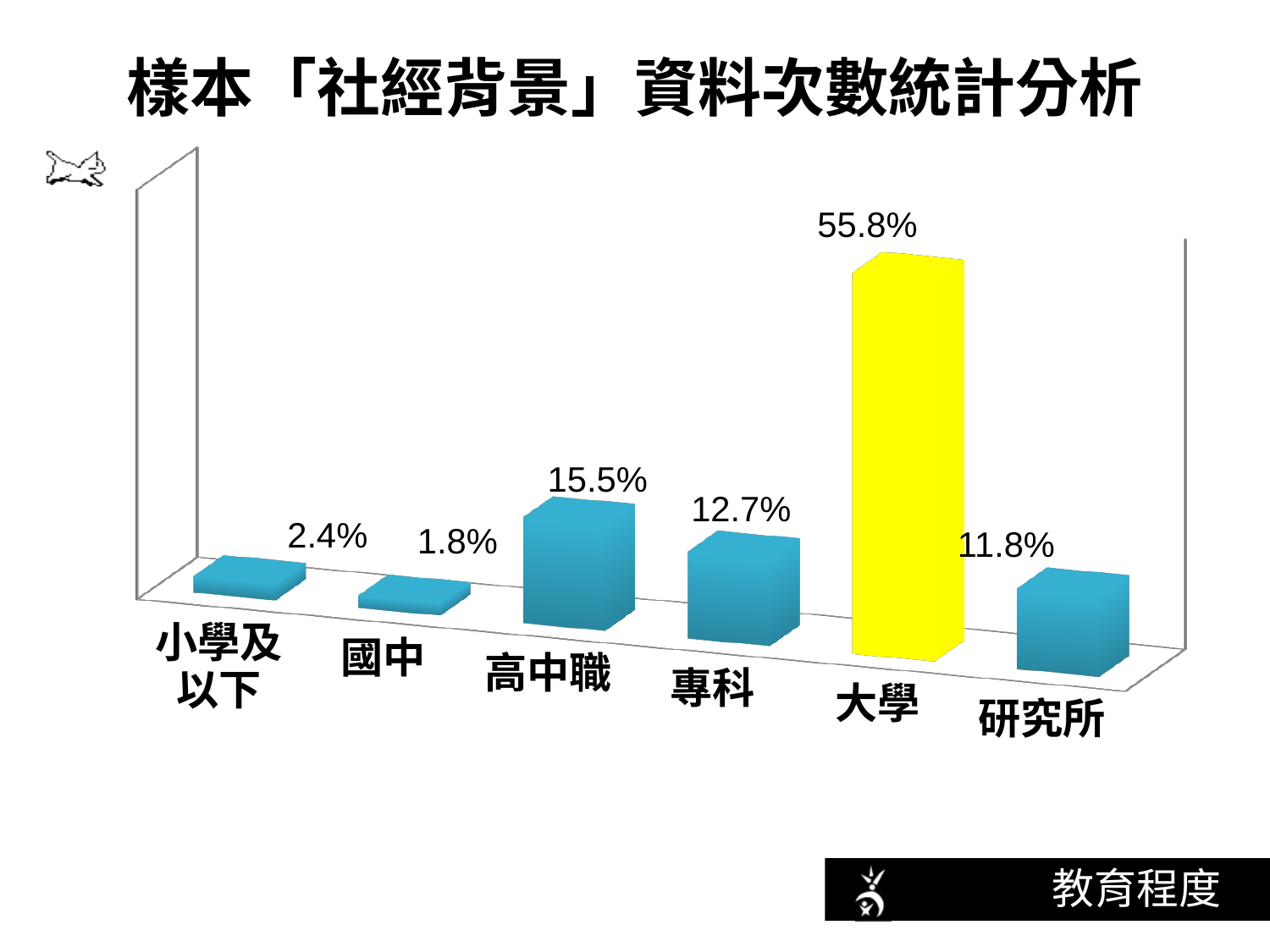
What kind of chart is shown on the slide? bar chart What is the value for 研究所? 11.8% What is the difference between the values for 大學 and 高中職? 40.3% What is the value for 高中職? 15.5% Which category has the lowest value? 國中 How many categories are shown in the chart? 6 Which is larger, the value for 高中職 or the value for 專科? 高中職 What is the value for 大學? 55.8% What is the difference between the values for 專科 and 研究所? 0.9% Which category has the highest value? 大學 Which bar is coloured yellow instead of blue? 大學 What is the value for 小學及以下? 2.4%